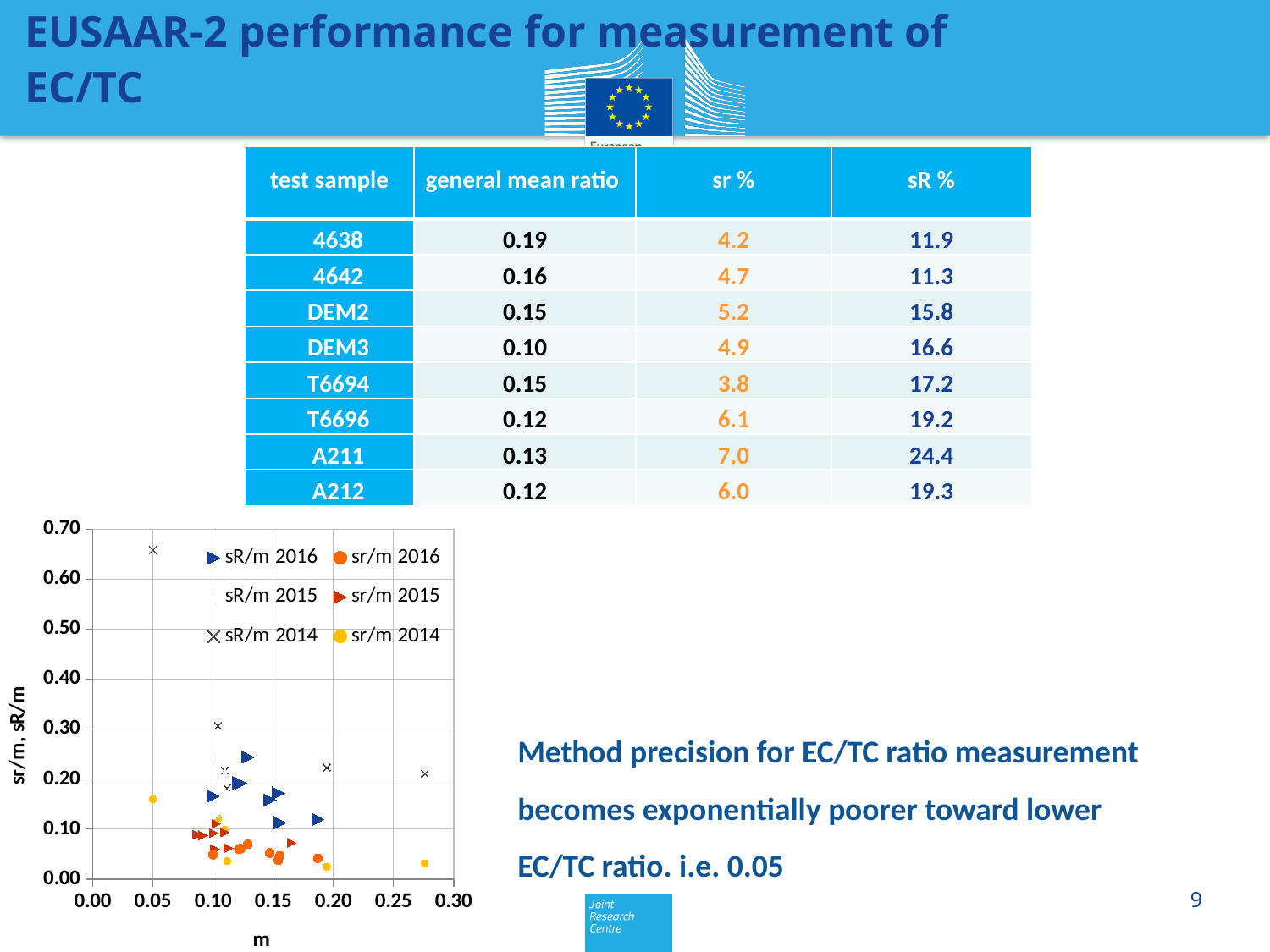
In the scatter chart, which series has the point with the highest y value? sR/m 2014 What is the label of the y axis of the scatter chart? sr/m, sR/m What is the label of the x axis of the scatter chart? m What is the highest tick value shown on the x axis of the scatter chart? 0.30 In the scatter chart, is the highest sR/m 2014 point greater or less than 0.60? greater How many series does the legend of the scatter chart list? 6 What kind of chart is shown at the bottom left of the slide? scatter chart In the scatter chart, is the sr/m 2014 point near m = 0.28 greater or less than 0.10? less In the scatter chart, is the sr/m 2014 point at m = 0.05 greater or less than 0.20? less What is the highest tick value shown on the y axis of the scatter chart? 0.70